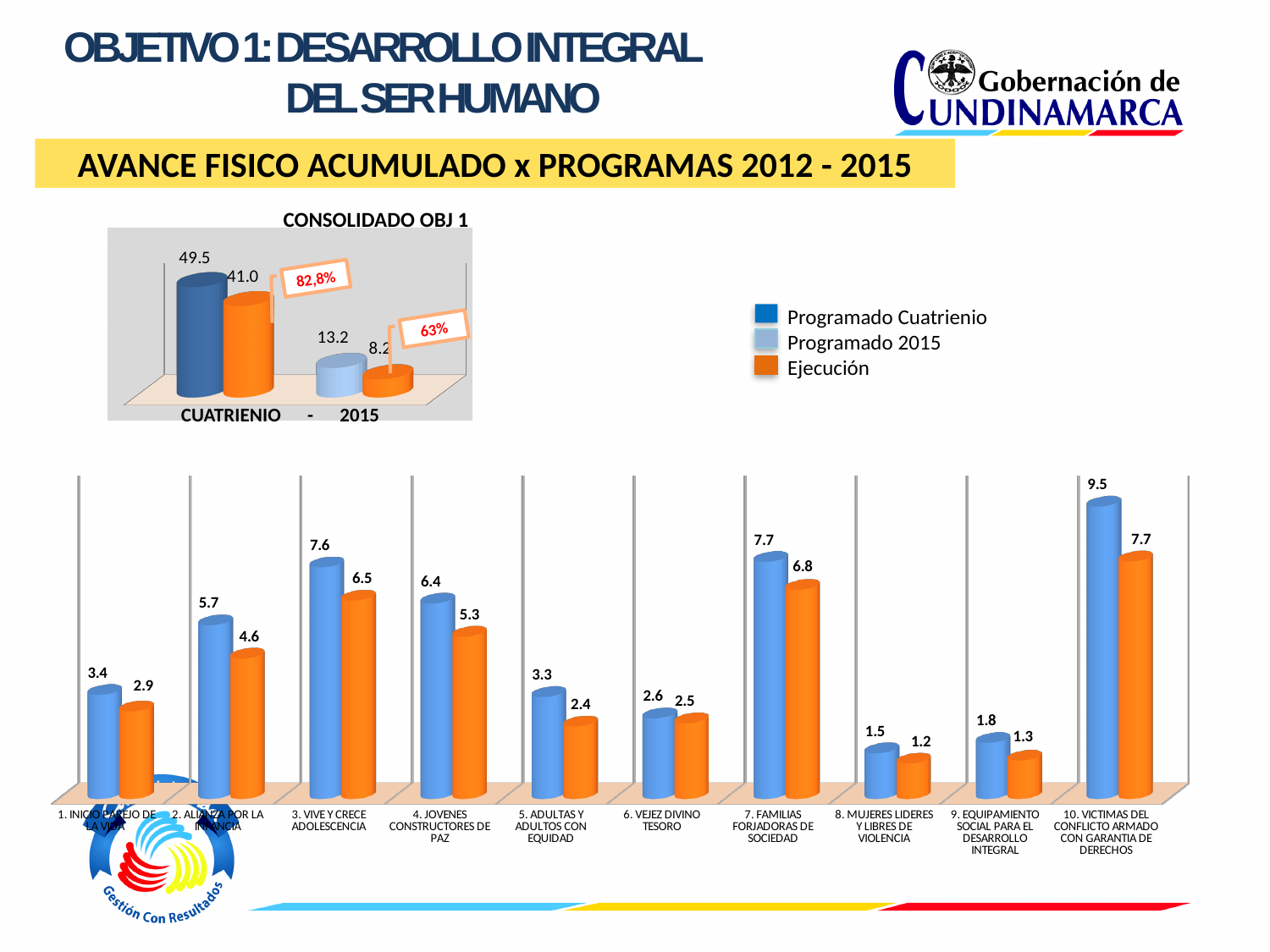
In the CONSOLIDADO OBJ 1 chart, what is the difference between the Programado Cuatrienio value (49.5) and the Ejecución value (41.0) for CUATRIENIO? 8.5 What type of chart is the bottom chart? Bar chart In the bottom chart, which program has the lowest orange (Ejecución) bar? 8. MUJERES LIDERES Y LIBRES DE VIOLENCIA How many programs (categories) are shown in the bottom chart? 10 In the CONSOLIDADO OBJ 1 chart, what is the Ejecución value for 2015? 8.2 In the CONSOLIDADO OBJ 1 chart, what percentage is shown in the callout for CUATRIENIO? 82,8% In the bottom chart, which program has the highest blue (Programado 2015) bar? 10. VICTIMAS DEL CONFLICTO ARMADO CON GARANTIA DE DERECHOS In the bottom chart, which is larger: the orange bar for 4. JOVENES CONSTRUCTORES DE PAZ or the orange bar for 7. FAMILIAS FORJADORAS DE SOCIEDAD? 7. FAMILIAS FORJADORAS DE SOCIEDAD In the CONSOLIDADO OBJ 1 chart, what is the Programado Cuatrienio value for CUATRIENIO? 49.5 In the bottom chart, what is the value of the orange (Ejecución) bar for 3. VIVE Y CRECE ADOLESCENCIA? 6.5 In the bottom chart, what is the difference between the blue bar (9.5) and the orange bar (7.7) for 10. VICTIMAS DEL CONFLICTO ARMADO CON GARANTIA DE DERECHOS? 1.8 How many series does the legend on the slide list? 3